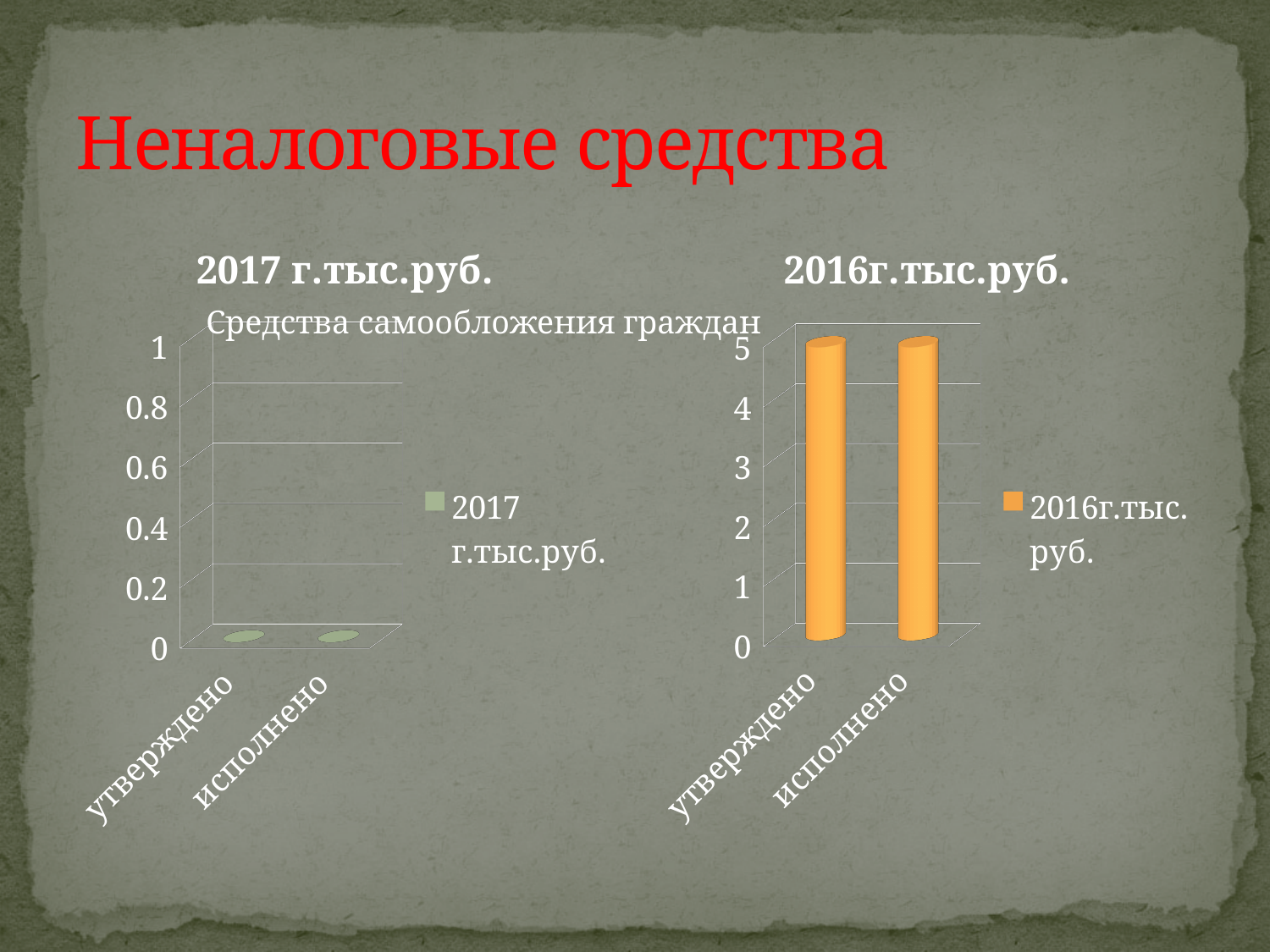
How many categories are shown on the x axis of the right chart (2016г.тыс.руб.)? 2 In the left chart (2017 г.тыс.руб.), is the value for исполнено greater or less than 0.4? less What kind of chart is the left chart titled "2017 г.тыс.руб."? bar chart What is the legend entry of the left chart (2017 г.тыс.руб.)? 2017 г.тыс.руб. How many series does the legend of the right chart (2016г.тыс.руб.) list? 1 In the left chart (2017 г.тыс.руб.), what is the value for утверждено? 0 How many categories are shown on the x axis of the left chart (2017 г.тыс.руб.)? 2 In the right chart (2016г.тыс.руб.), is the value for исполнено greater or less than 3? greater What is the chart title printed above the plot area of the left chart (2017 г.тыс.руб.)? 2017 г.тыс.руб. What kind of chart is the right chart titled "2016г.тыс.руб."? bar chart